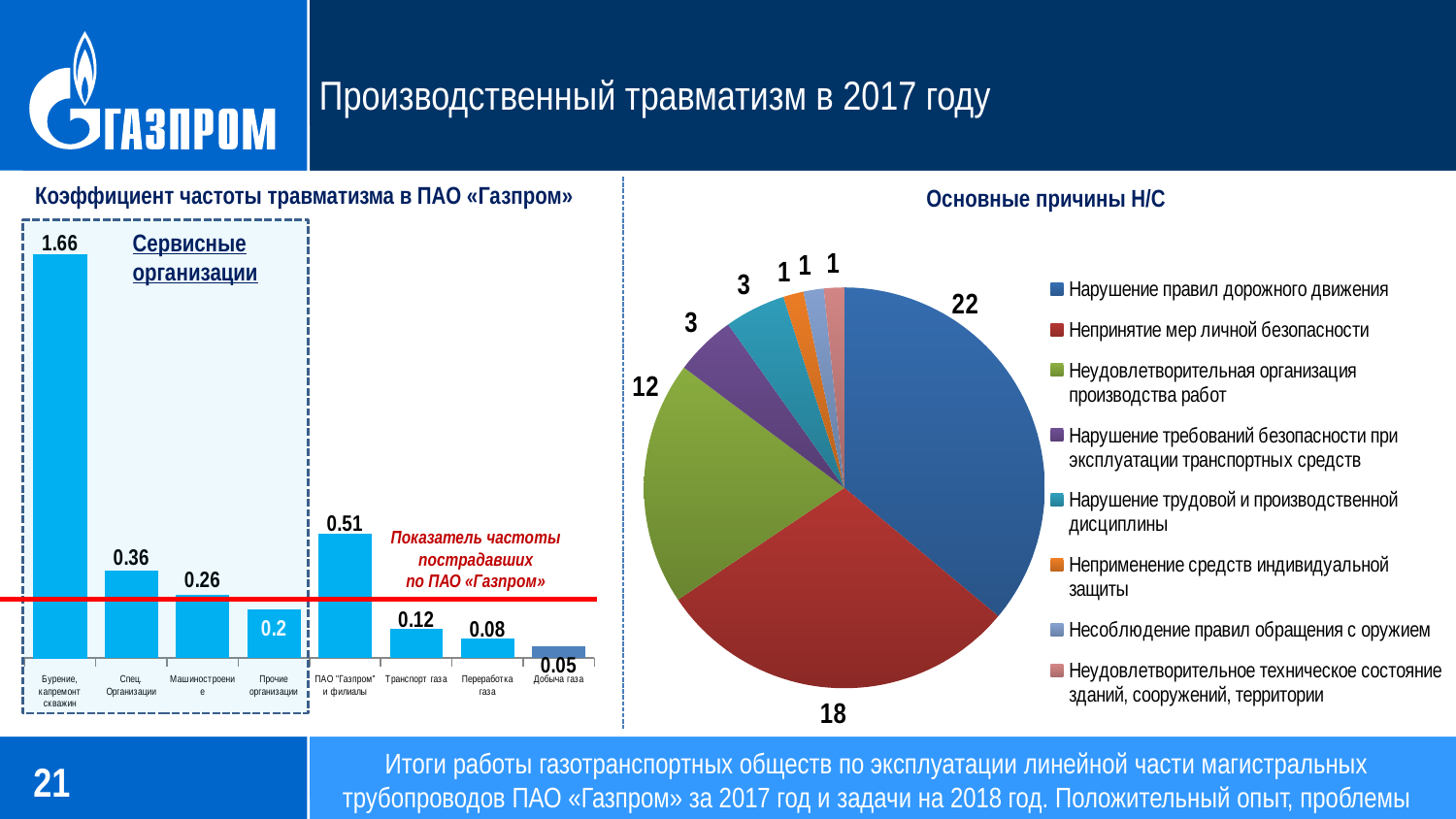
In the bar chart «Коэффициент частоты травматизма в ПАО «Газпром»», what is the value for Бурение, капремонт скважин? 1.66 In the bar chart «Коэффициент частоты травматизма в ПАО «Газпром»», which category has the lowest value? Добыча газа What type of chart is «Основные причины Н/С»? Pie chart In the pie chart «Основные причины Н/С», what is the difference between the values for Нарушение правил дорожного движения and Непринятие мер личной безопасности? 4 In the pie chart «Основные причины Н/С», what is the value for Нарушение правил дорожного движения? 22 In the bar chart «Коэффициент частоты травматизма в ПАО «Газпром»», what is the difference between the values for Спец. Организации and Машиностроение? 0.1 In the bar chart «Коэффициент частоты травматизма в ПАО «Газпром»», what is the value for ПАО "Газпром" и филиалы? 0.51 In the bar chart «Коэффициент частоты травматизма в ПАО «Газпром»», which is larger: the value for Транспорт газа or for Переработка газа? Транспорт газа How many entries does the legend of the pie chart «Основные причины Н/С» list? 8 How many categories are shown in the bar chart «Коэффициент частоты травматизма в ПАО «Газпром»»? 8 In the pie chart «Основные причины Н/С», what is the value for Неудовлетворительная организация производства работ? 12 In the bar chart «Коэффициент частоты травматизма в ПАО «Газпром»», which category has the highest value? Бурение, капремонт скважин